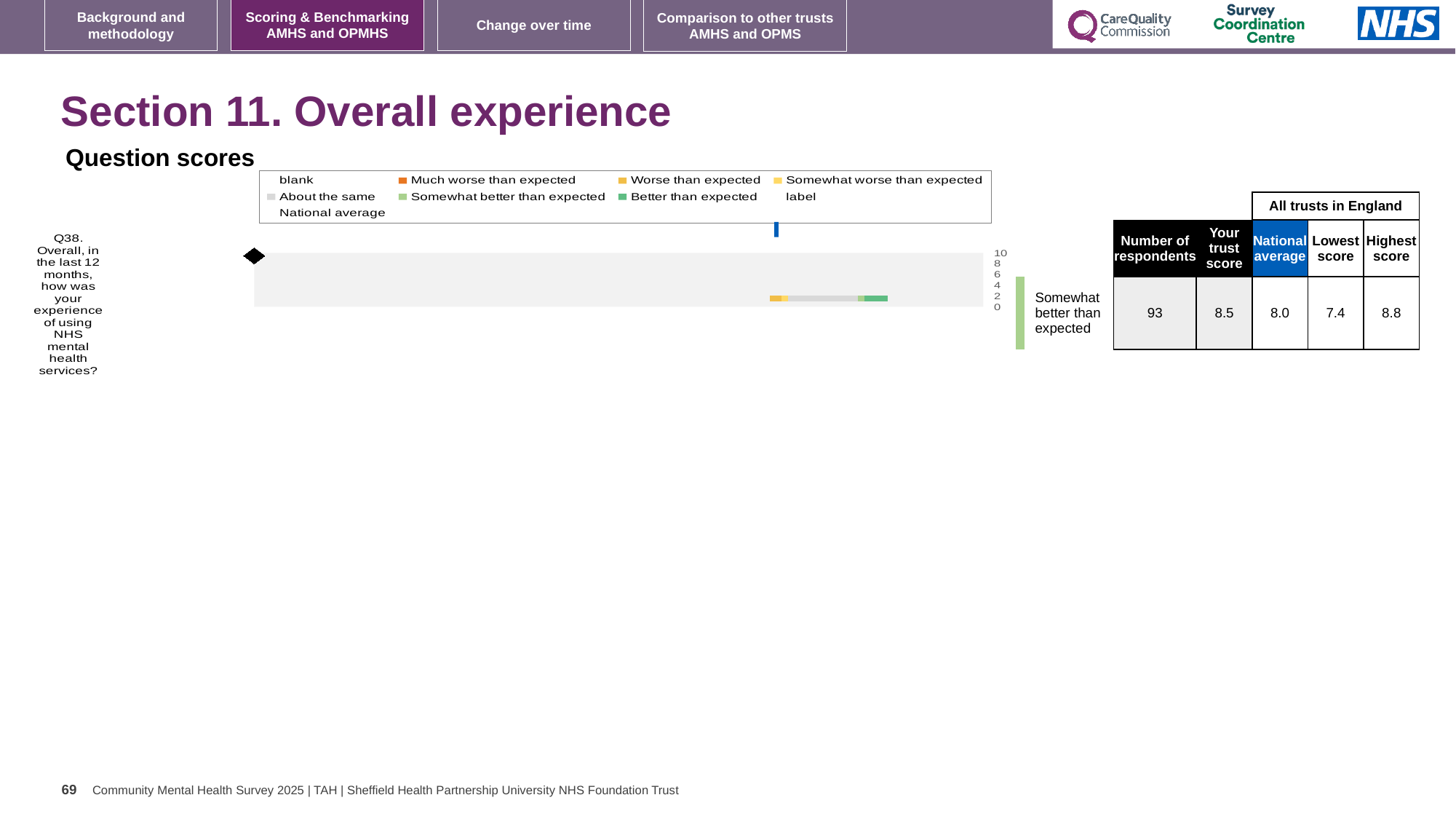
How many respondents are listed for Q38? 93 Which question number is plotted in the Question scores chart? Q38 What is the difference between the highest and lowest scores for Q38 across all trusts in England? 1.4 For Q38, which is larger: the trust's score or the national average? the trust's score What benchmark category is shown next to the Q38 bar? Somewhat better than expected What is the trust's score for Q38? 8.5 What is the lowest score among all trusts in England for Q38? 7.4 What is the highest score among all trusts in England for Q38? 8.8 How many survey questions are plotted in the Question scores chart? 1 By how much does the trust's Q38 score exceed the national average? 0.5 What is the national average score for Q38? 8.0 What kind of chart is used to show the Q38 question score? bar chart